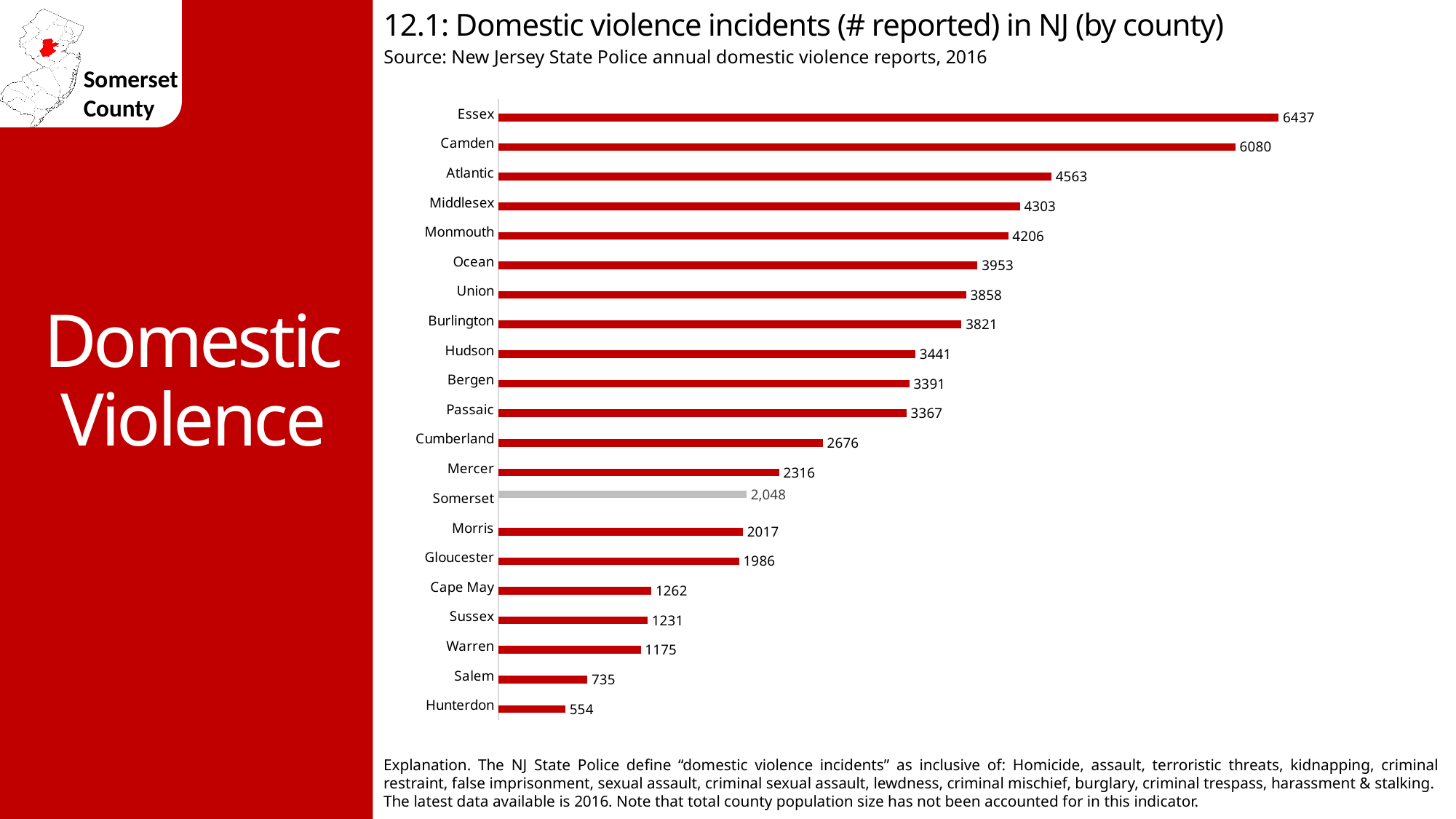
Which county's bar is shown in grey rather than red? Somerset Which county has the lowest number of reported domestic violence incidents? Hunterdon How many domestic violence incidents were reported in Essex County? 6437 Which county has more reported incidents, Atlantic or Middlesex? Atlantic How many incidents were reported in Hunterdon County? 554 Which county has the highest number of reported domestic violence incidents? Essex How many counties are shown in the chart? 21 What is the value shown for Somerset County? 2,048 What is the difference between the values for Essex and Camden? 357 Which county has more reported incidents, Salem or Warren? Warren What is the difference between the values for Somerset and Morris? 31 What type of chart is used on this slide? Bar chart